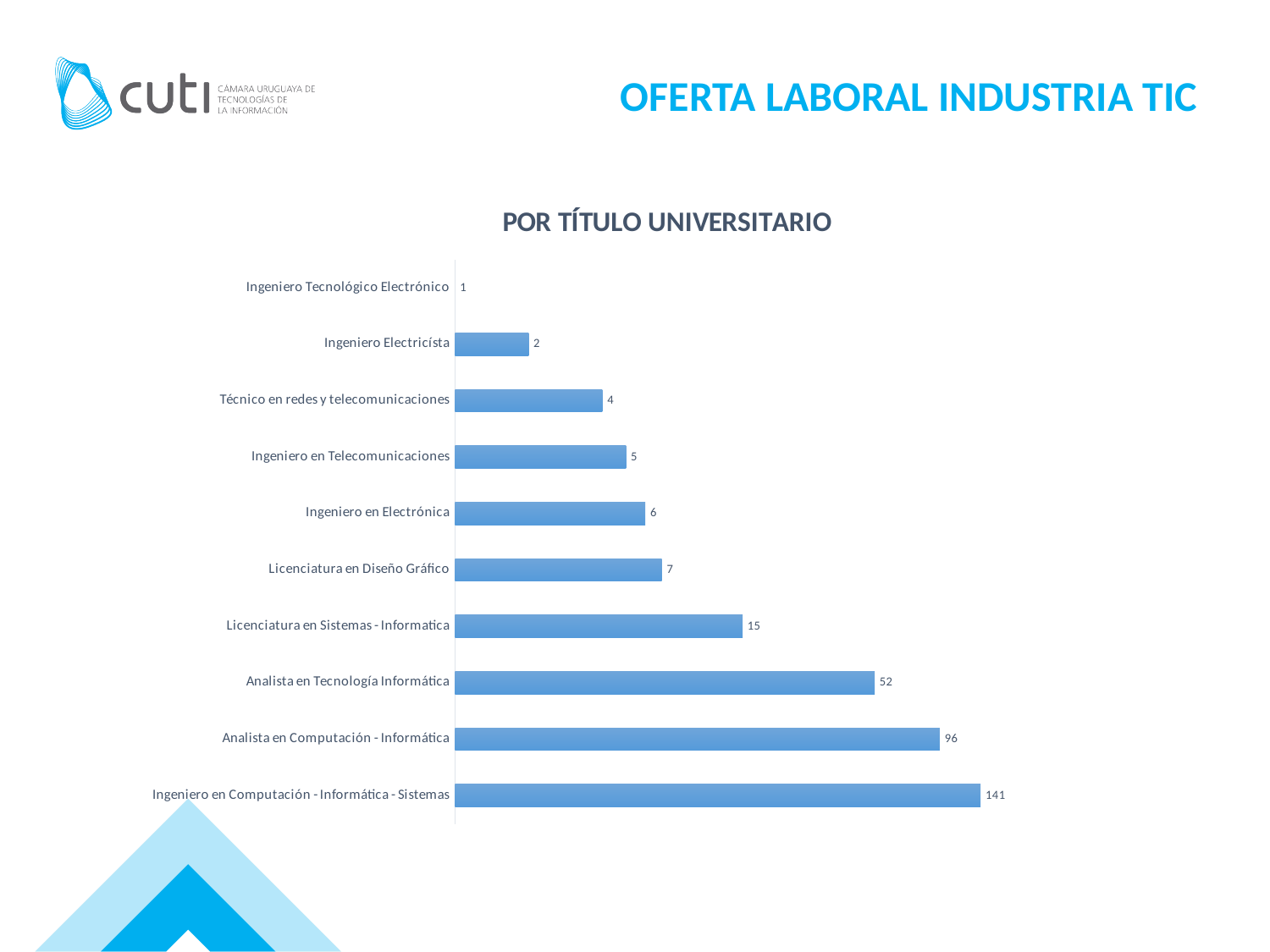
What is the value for Analista en Computación - Informática? 96 What is the difference between the values for Analista en Tecnología Informática and Licenciatura en Sistemas - Informatica? 37 What is the value for Ingeniero en Telecomunicaciones? 5 What kind of chart is shown on the slide? Bar chart What is the title of the chart? POR TÍTULO UNIVERSITARIO What is the value for Técnico en redes y telecomunicaciones? 4 What is the value for Licenciatura en Sistemas - Informatica? 15 Which category has the lowest value? Ingeniero Tecnológico Electrónico How many categories are shown in the chart? 10 Which is larger, the value for Licenciatura en Diseño Gráfico or the value for Ingeniero en Electrónica? Licenciatura en Diseño Gráfico Which category has the highest value? Ingeniero en Computación - Informática - Sistemas What is the difference between the values for Ingeniero en Computación - Informática - Sistemas and Analista en Computación - Informática? 45